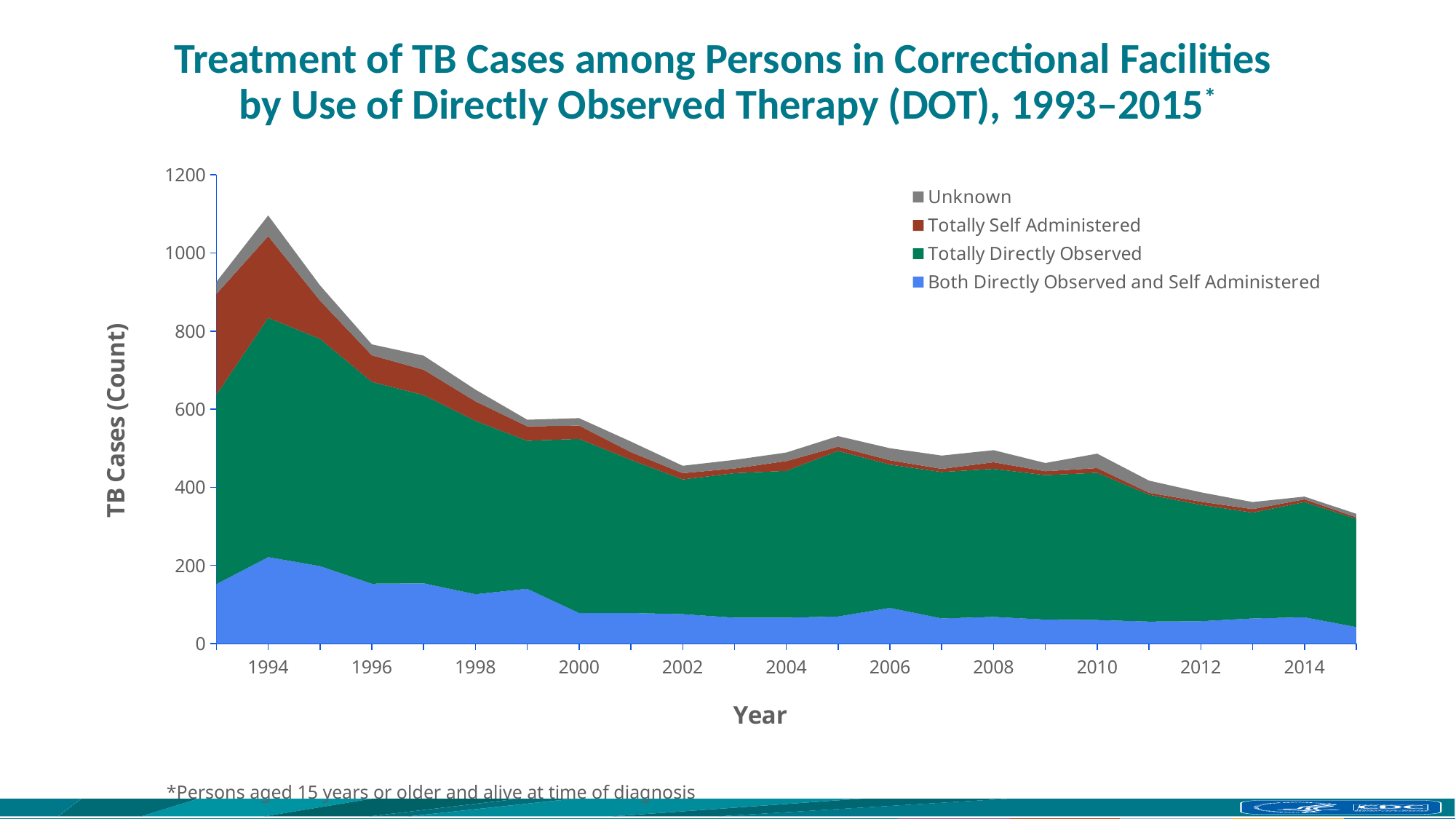
In which year is the total number of TB cases lowest? 2015 Which series is shown in blue at the bottom of the chart? Both Directly Observed and Self Administered How many series does the legend list? 4 Is the value for Both Directly Observed and Self Administered in 1994 greater or less than 100? greater In which year does the total number of TB cases reach its highest point? 1994 What kind of chart is shown on the slide? Stacked area chart What is the label of the vertical axis? TB Cases (Count) Overall, does the total number of TB cases rise or fall from 1994 to 2015? fall Which year has a larger total number of TB cases, 1994 or 2014? 1994 Is the total number of TB cases in 1994 greater or less than 1000? greater Is the total number of TB cases in 2002 greater or less than 600? less